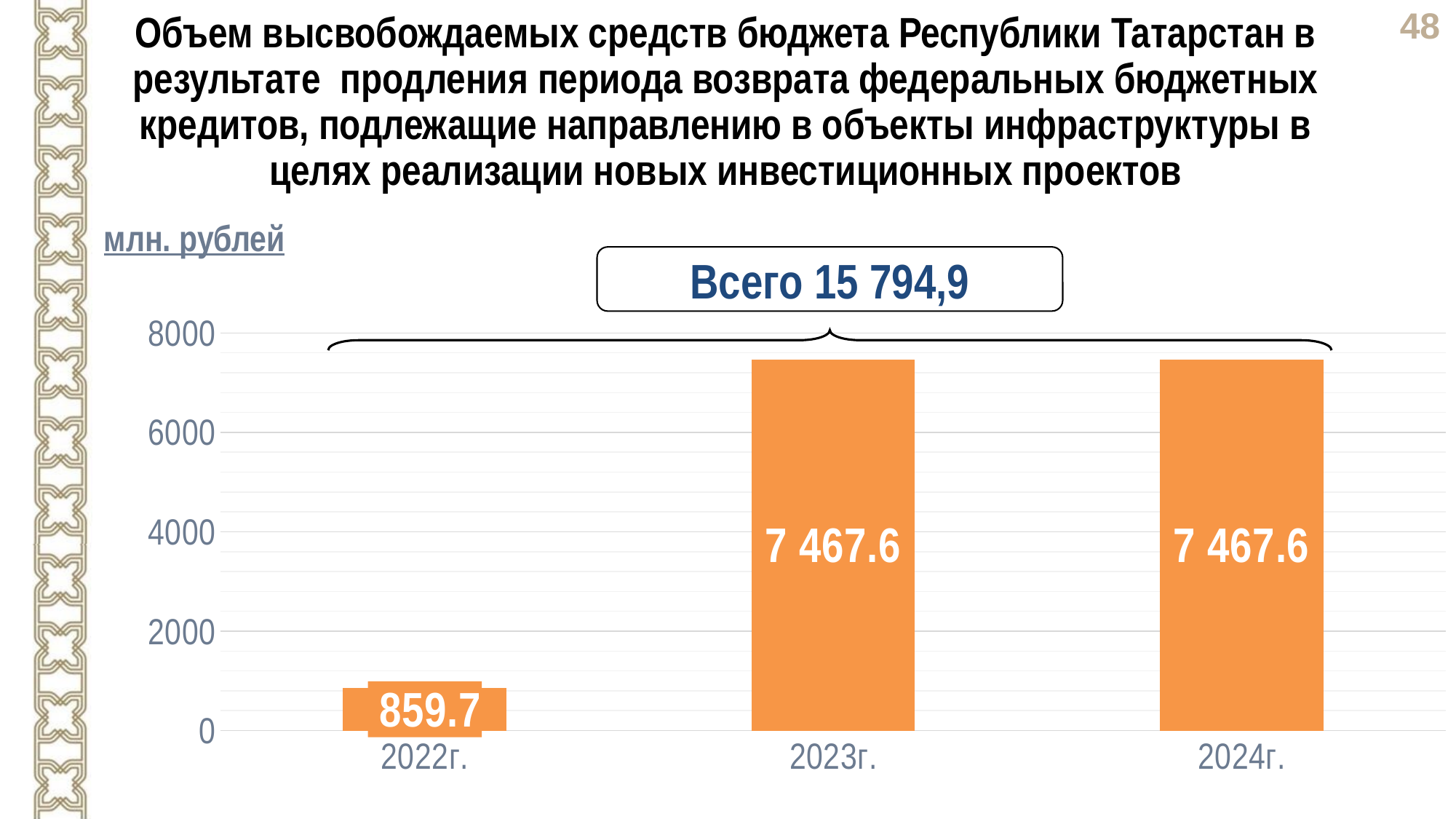
Which is larger, the value for 2022г. or the value for 2023г.? 2023г. What is the value for 2024г.? 7 467.6 What kind of chart is shown on the slide? bar chart What is the value for 2022г.? 859.7 Which year has the lowest value? 2022г. Is the value for 2022г. greater or less than 2000? less What total is shown in the box above the bars? Всего 15 794,9 Does the value rise or fall from 2022г. to 2023г.? rise What is the difference between the values for 2023г. and 2022г.? 6 607.9 Is the value for 2024г. greater or less than 6000? greater How many years are shown on the x axis? 3 What is the value for 2023г.? 7 467.6